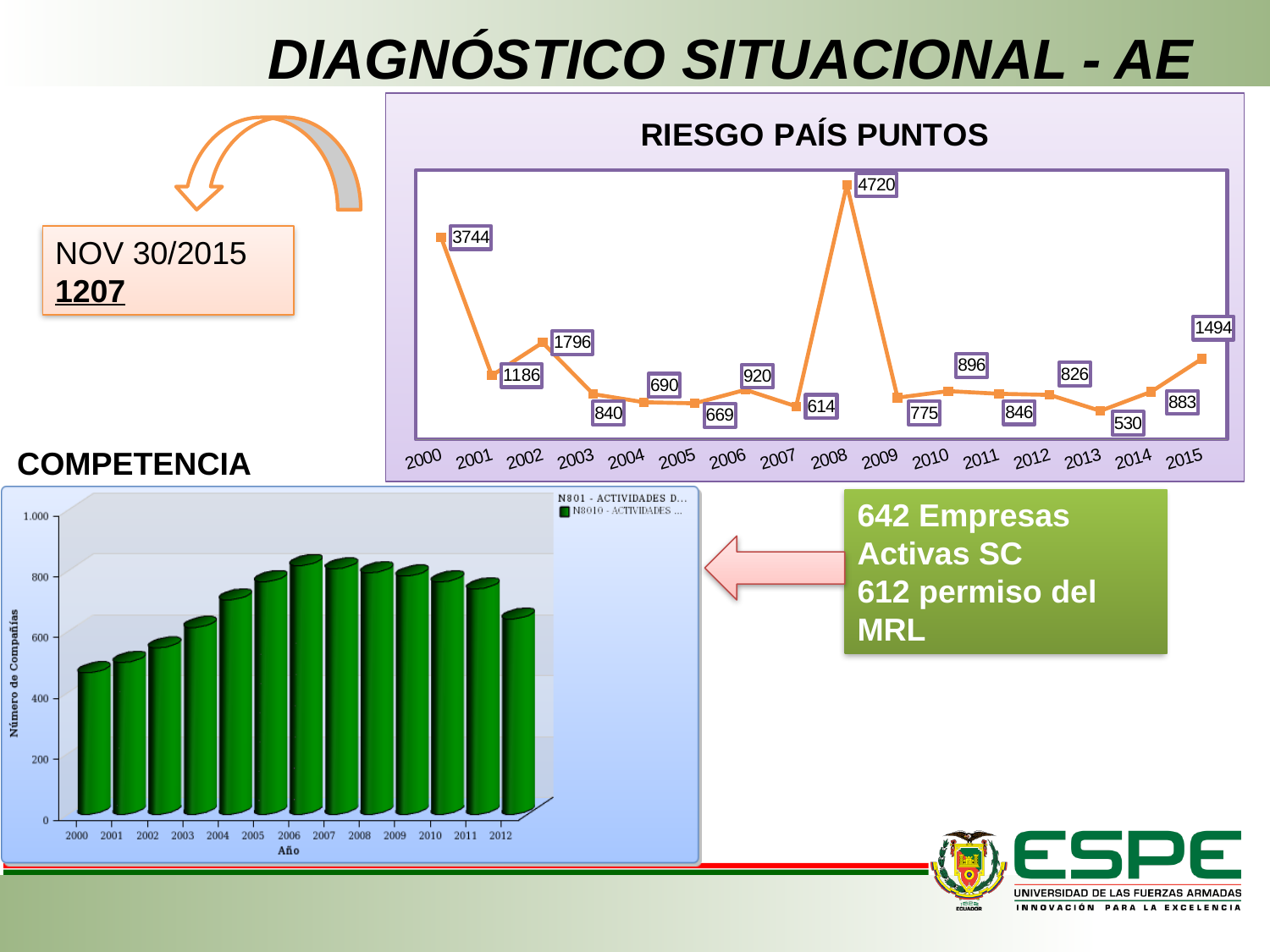
In the RIESGO PAÍS PUNTOS chart, what is the value for 2013? 530 In the RIESGO PAÍS PUNTOS chart, what is the value for 2008? 4720 In the RIESGO PAÍS PUNTOS chart, which year has the lowest value? 2013 What kind of chart is the COMPETENCIA chart at the bottom left of the slide? Bar chart In the RIESGO PAÍS PUNTOS chart, which is larger, the value for 2010 or the value for 2011? 2010 In the RIESGO PAÍS PUNTOS chart, which year has the highest value? 2008 In the RIESGO PAÍS PUNTOS chart, how many years are plotted? 16 In the COMPETENCIA bar chart, is the value for 2000 greater or less than 600? less In the RIESGO PAÍS PUNTOS chart, what is the difference between the values for 2000 and 2001? 2558 In the COMPETENCIA bar chart, how many years are shown on the x axis? 13 What kind of chart is the RIESGO PAÍS PUNTOS chart? Line chart In the RIESGO PAÍS PUNTOS chart, do the values rise or fall from 2013 to 2015? Rise